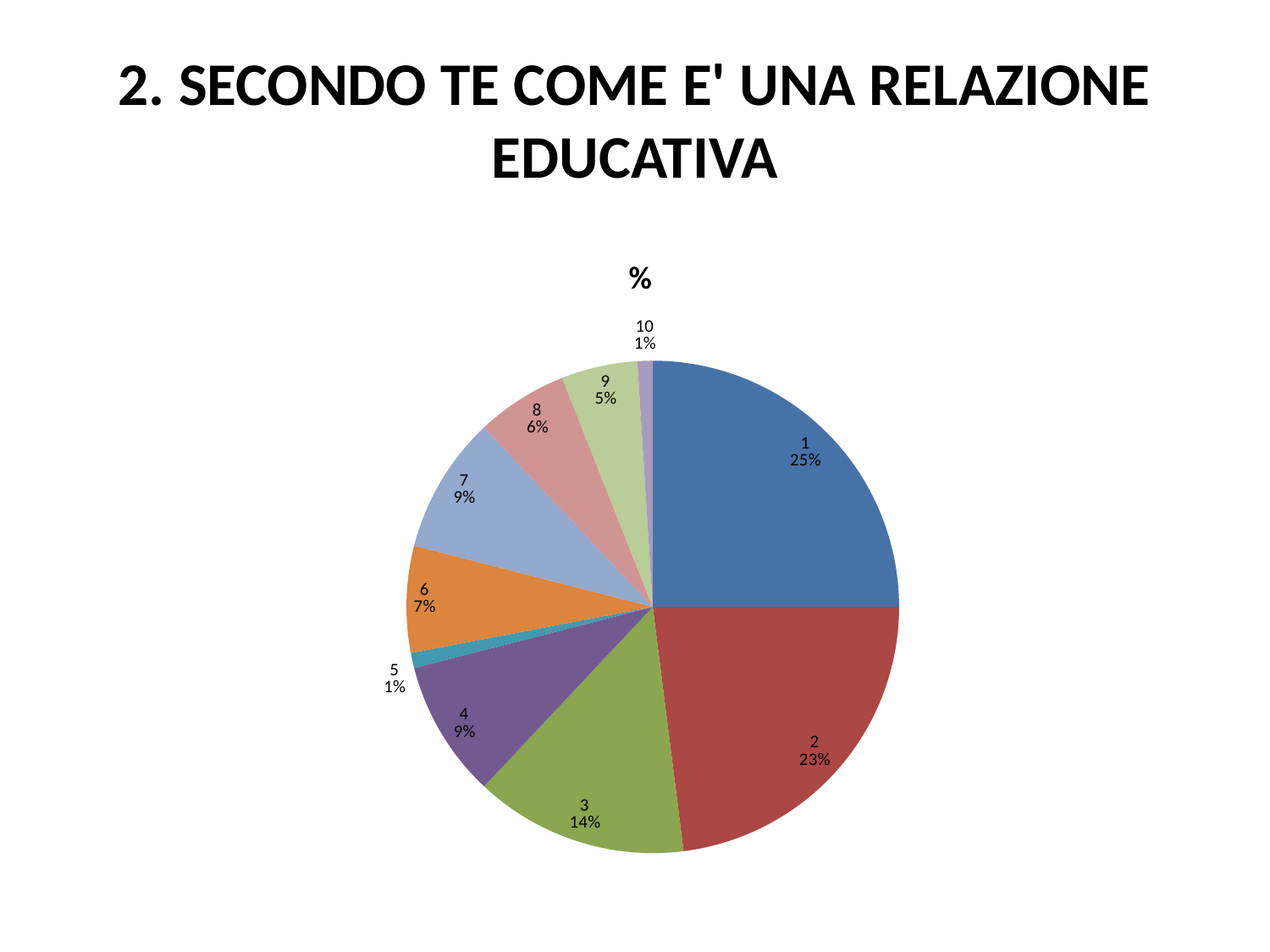
What percentage is shown for slice 1? 25% How many slices does the pie chart have? 10 Which is larger, slice 3 or slice 6? slice 3 What percentage is shown for slice 3? 14% What percentage is shown for slice 10? 1% What kind of chart is shown on the slide? pie chart What is the chart's title? % What percentage is shown for slice 7? 9% What is the difference in percentage points between slice 1 and slice 2? 2 Which slice has the largest share of the pie? 1 What is the combined share of slices 1 and 2? 48% What percentage is shown for slice 8? 6%